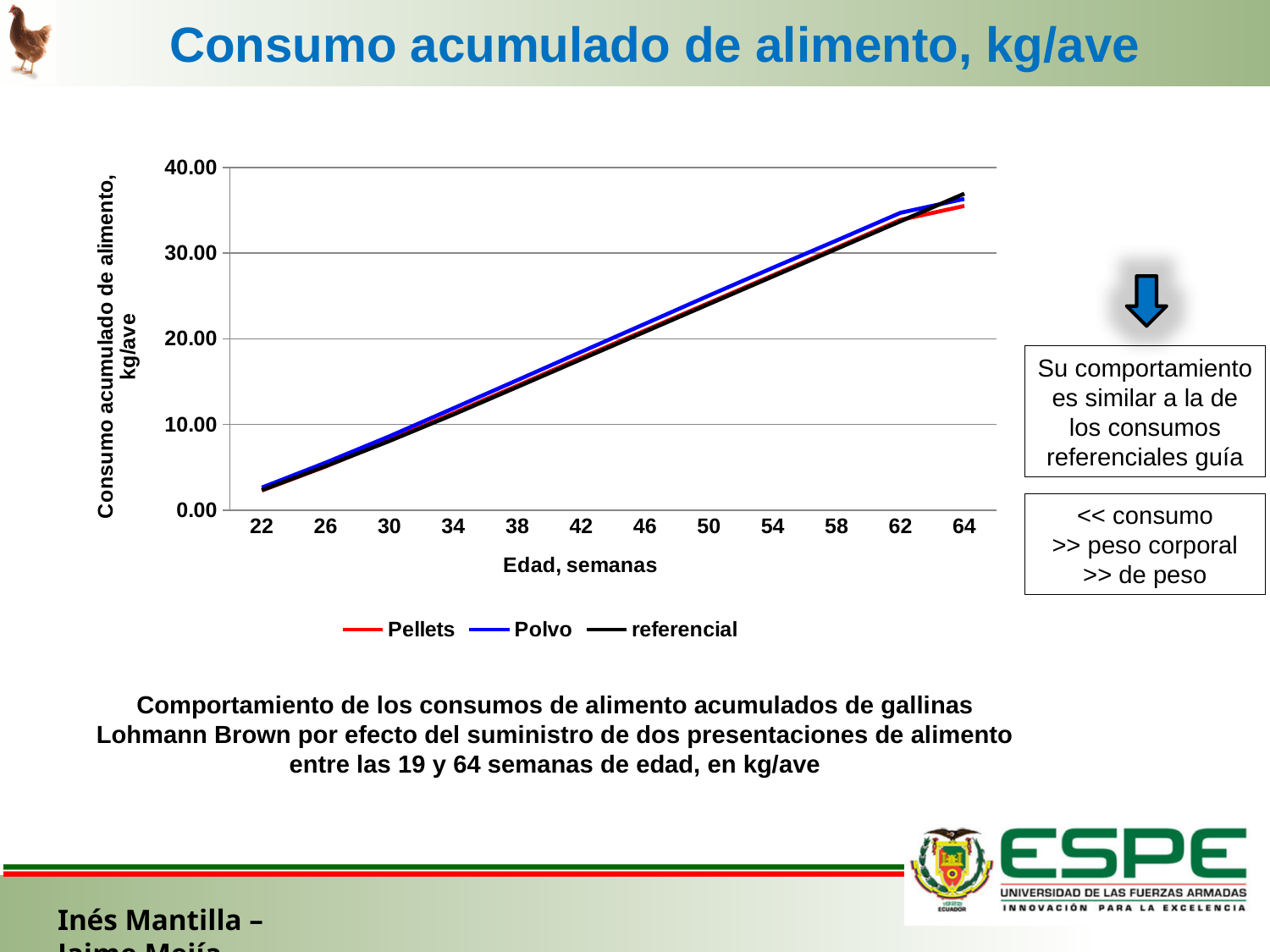
What kind of chart is shown on the slide? line chart Do the values for Pellets rise or fall as age in weeks increases? rise Is the value for Polvo at 50 weeks greater or less than 20.00? greater Which series has the lowest value at 64 weeks? Pellets Which series are listed in the chart legend? Pellets, Polvo, referencial How many series does the legend list? 3 Do the values for Polvo rise or fall along the x axis? rise Is the value for Pellets at 22 weeks greater or less than 10.00? less Is the value for Polvo at 64 weeks greater or less than 30.00? greater What is the title of the x axis of the chart? Edad, semanas